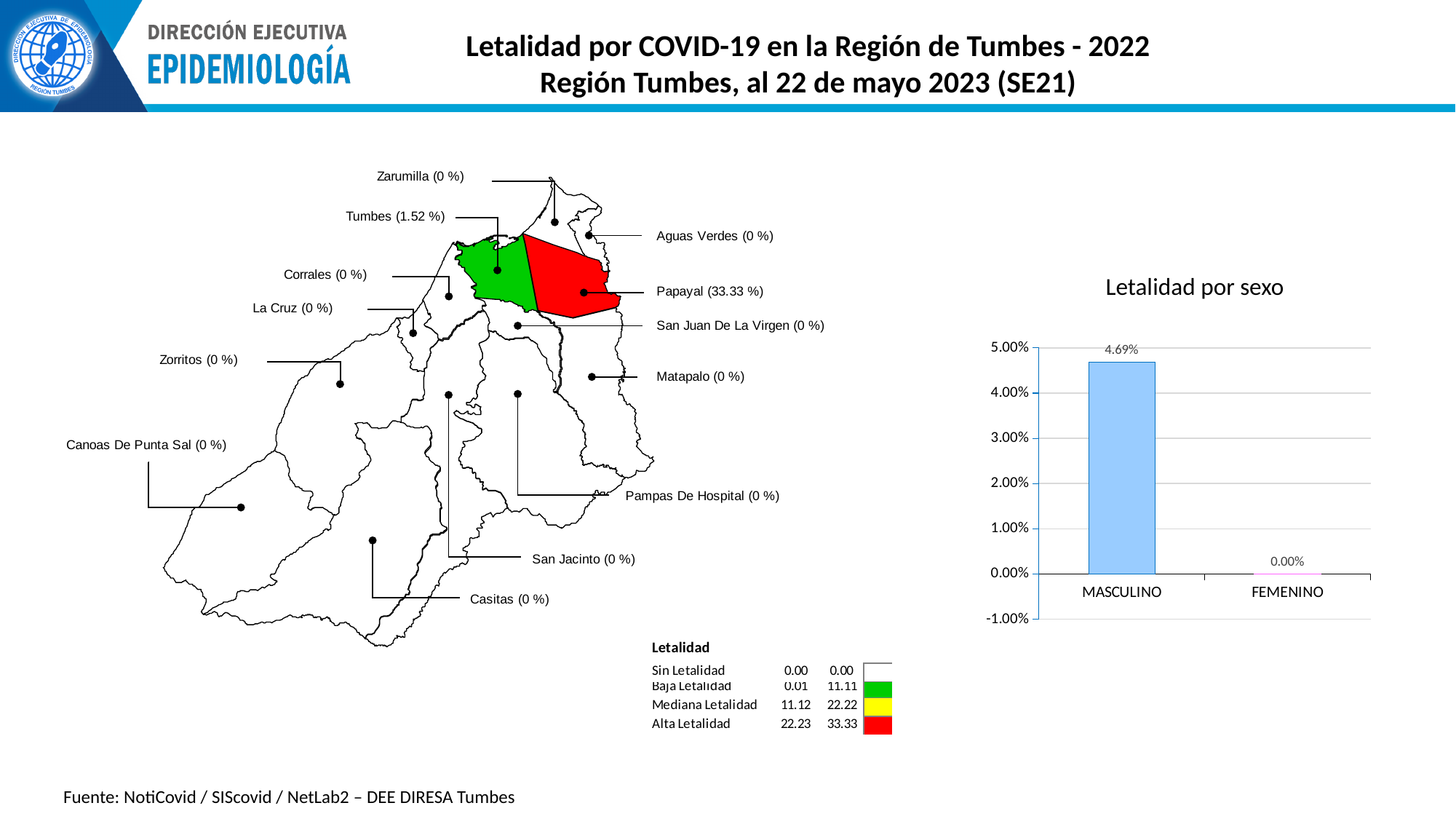
In the 'Letalidad por sexo' chart, is the value for MASCULINO greater or less than 4.00%? greater In the 'Letalidad por sexo' chart, which category has the highest value? MASCULINO In the 'Letalidad por sexo' chart, which category has the lowest value? FEMENINO In the 'Letalidad por sexo' chart, what is the value for FEMENINO? 0.00% In the 'Letalidad por sexo' chart, what is the difference between the MASCULINO and FEMENINO values? 4.69% What is the title of the chart on the right side of the slide? Letalidad por sexo What kind of chart is 'Letalidad por sexo'? bar chart On the map, what is the lethality value shown for Tumbes? 1.52 % In the 'Letalidad por sexo' chart, what is the value for MASCULINO? 4.69% How many categories are shown in the 'Letalidad por sexo' chart? 2 In the 'Letalidad por sexo' chart, which is larger, the value for MASCULINO or for FEMENINO? MASCULINO On the map, what is the lethality value shown for Papayal? 33.33 %